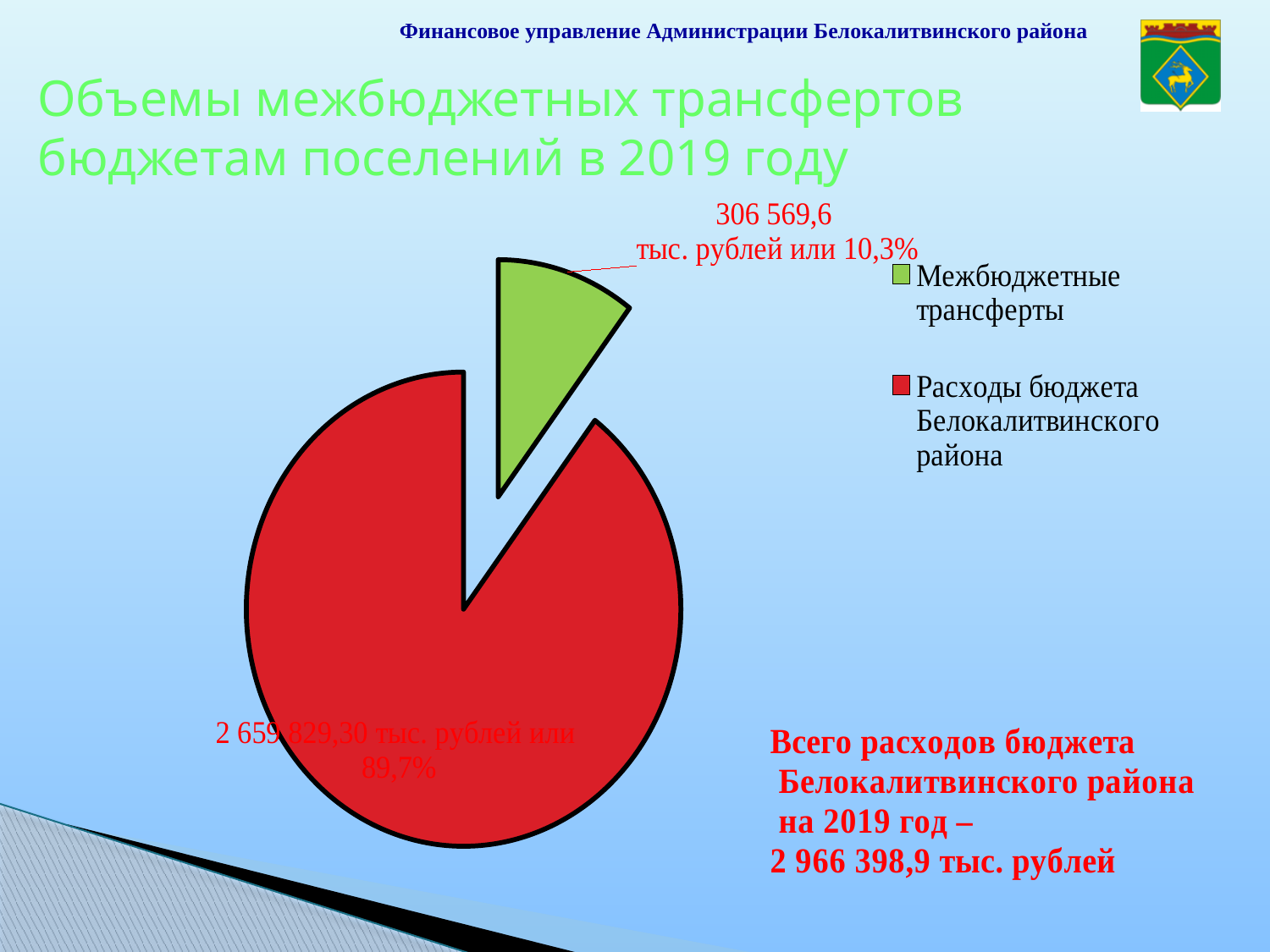
Which is larger: the share for "Межбюджетные трансферты" or the share for "Расходы бюджета Белокалитвинского района"? Расходы бюджета Белокалитвинского района How many entries does the legend of the pie chart list? 2 Which slice of the pie chart is the largest? Расходы бюджета Белокалитвинского района What value in тыс. рублей is labelled on the "Межбюджетные трансферты" slice? 306 569,6 тыс. рублей What kind of chart is shown on the slide? pie chart What is the difference in percentage points between the share of "Расходы бюджета Белокалитвинского района" and the share of "Межбюджетные трансферты"? 79,4 What share of the pie does the slice "Межбюджетные трансферты" represent? 10,3% What colour is the slice for "Расходы бюджета Белокалитвинского района"? red What share of the pie does the slice "Расходы бюджета Белокалитвинского района" represent? 89,7% Which slice of the pie chart is the smallest? Межбюджетные трансферты What colour is the slice for "Межбюджетные трансферты"? green How many slices does the pie chart have? 2